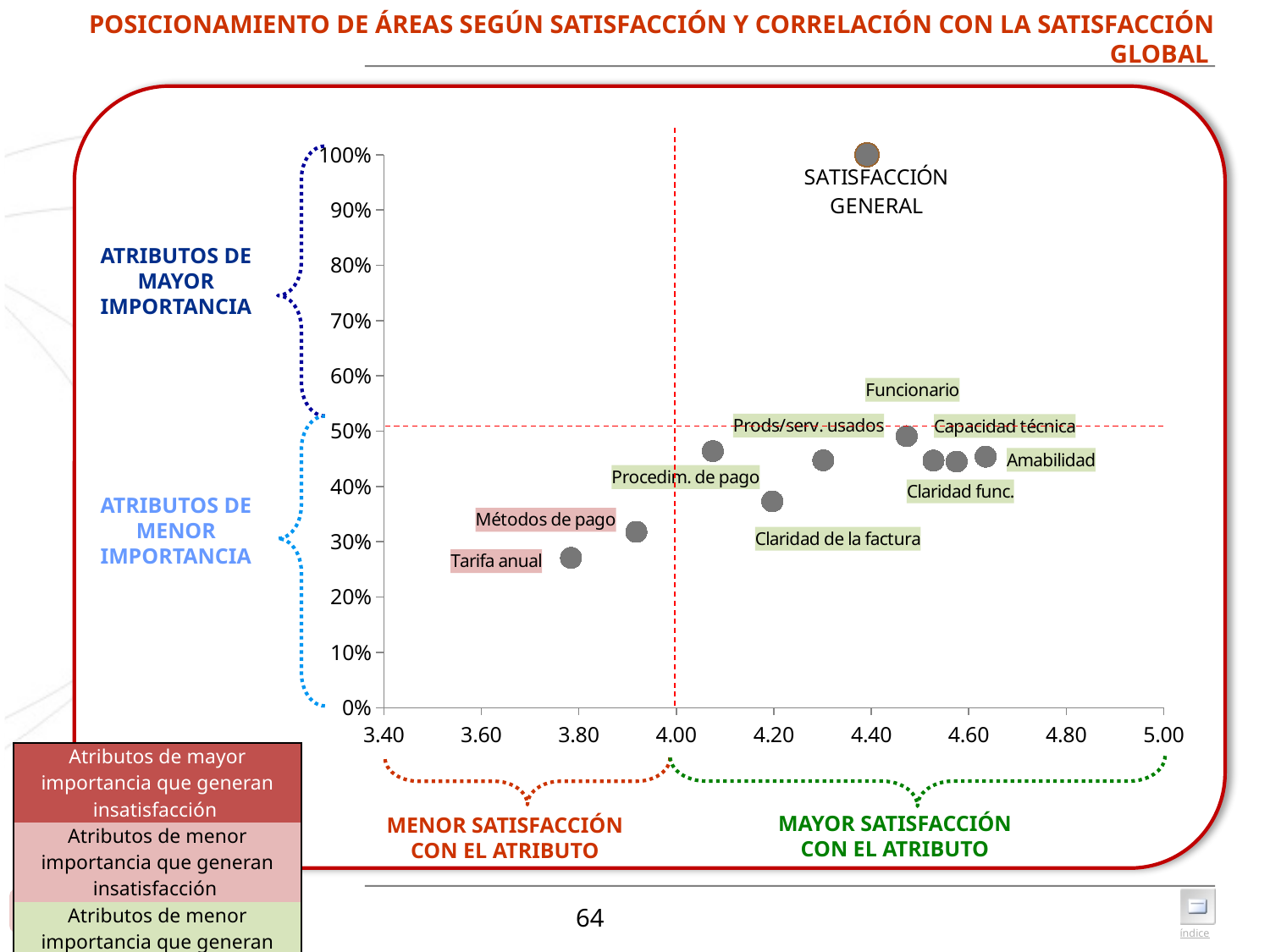
Which attribute has the lowest value on the vertical (percentage) axis? Tarifa anual Is the vertical-axis value for Tarifa anual greater or less than 30%? less Is the vertical-axis value for Claridad de la factura greater or less than 40%? less Which is positioned further to the right on the horizontal axis, Amabilidad or Métodos de pago? Amabilidad Which attribute is positioned furthest to the left on the horizontal axis? Tarifa anual At what horizontal-axis value is the vertical red dashed line drawn? 4.00 Which labelled point has the highest value on the vertical (percentage) axis? SATISFACCIÓN GENERAL Which has a higher vertical-axis value, Funcionario or Claridad de la factura? Funcionario Is the horizontal-axis value for Tarifa anual greater or less than 4.00? less How many labelled data points are plotted on the chart? 10 What kind of chart is shown on the slide? scatter chart